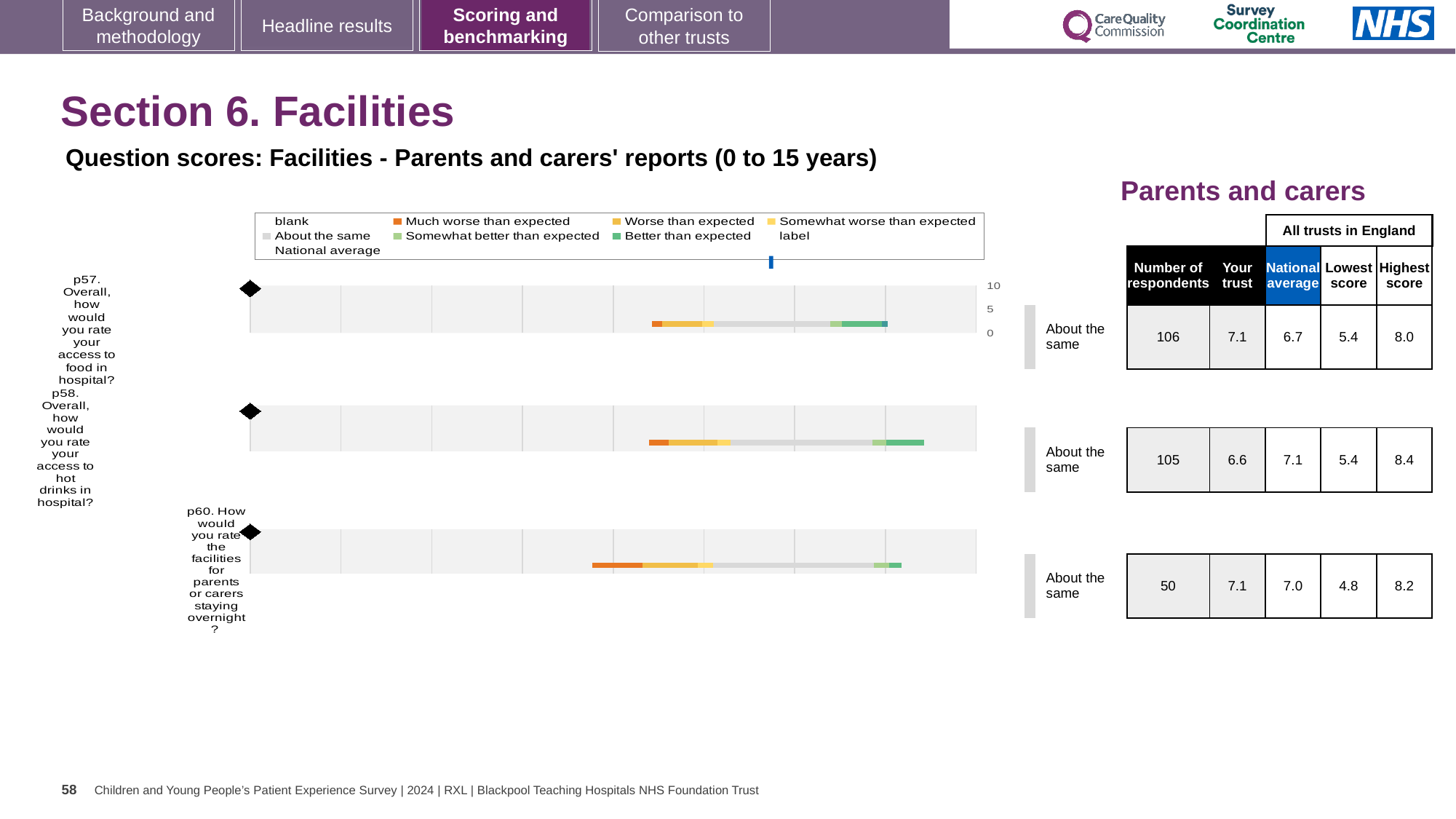
Which question has the lowest 'Your trust' score in the table: p57, p58 or p60? p58 According to the table, what is the lowest score among all trusts in England for p60? 4.8 According to the table, what is the highest score among all trusts in England for p58? 8.4 How many entries does the chart legend list? 9 According to the table, what is the national average for p58 (access to hot drinks in hospital)? 7.1 What is the difference between the highest score (8.0) and the lowest score (5.4) for p57 in the table? 2.6 According to the table, how many respondents answered p60 (facilities for parents or carers staying overnight)? 50 How many question charts (p57, p58, p60) are shown on the slide? 3 What benchmark category is shown next to each of the three charts? About the same According to the table, what is the 'Your trust' score for p57 (access to food in hospital)? 7.1 What kind of chart is used to show the question scores on this slide? bar chart What is the highest value shown on the chart axis? 10